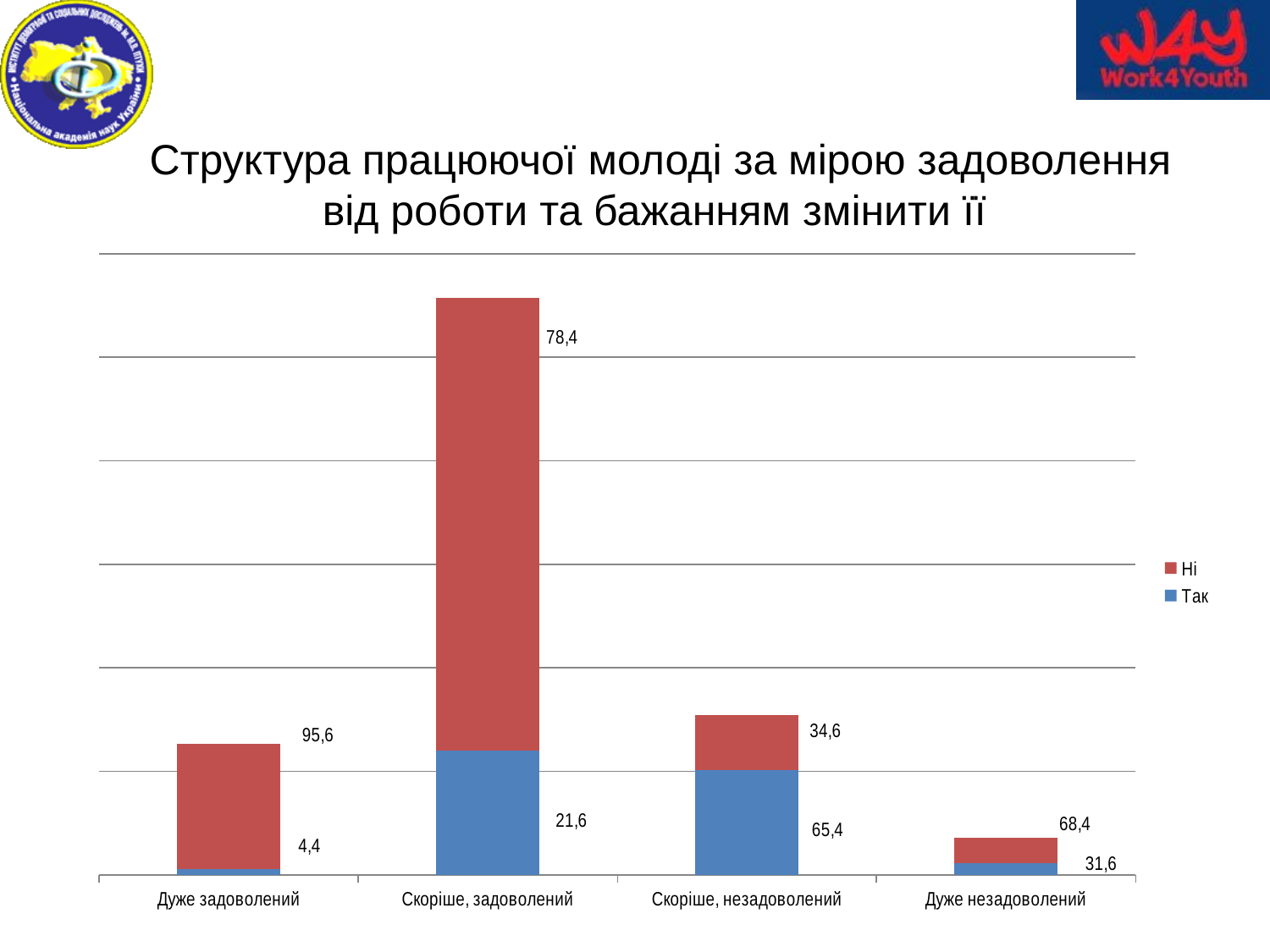
What is the value labelled for the "Так" series in the "Скоріше, незадоволений" category? 65,4 Which category has the shortest stacked bar? Дуже незадоволений What is the value labelled for the "Ні" series in the "Дуже незадоволений" category? 68,4 In the "Скоріше, незадоволений" category, which labelled value is larger, "Ні" or "Так"? Так Which category has the tallest stacked bar? Скоріше, задоволений What is the value labelled for the "Ні" series in the "Дуже задоволений" category? 95,6 What is the difference between the "Ні" and "Так" labelled values in the "Дуже задоволений" category? 91,2 How many categories are shown on the x axis? 4 What kind of chart is shown on the slide? Stacked bar chart What is the value labelled for the "Так" series in the "Скоріше, задоволений" category? 21,6 Which colour represents the "Так" series in the legend? Blue How many series does the legend list? 2